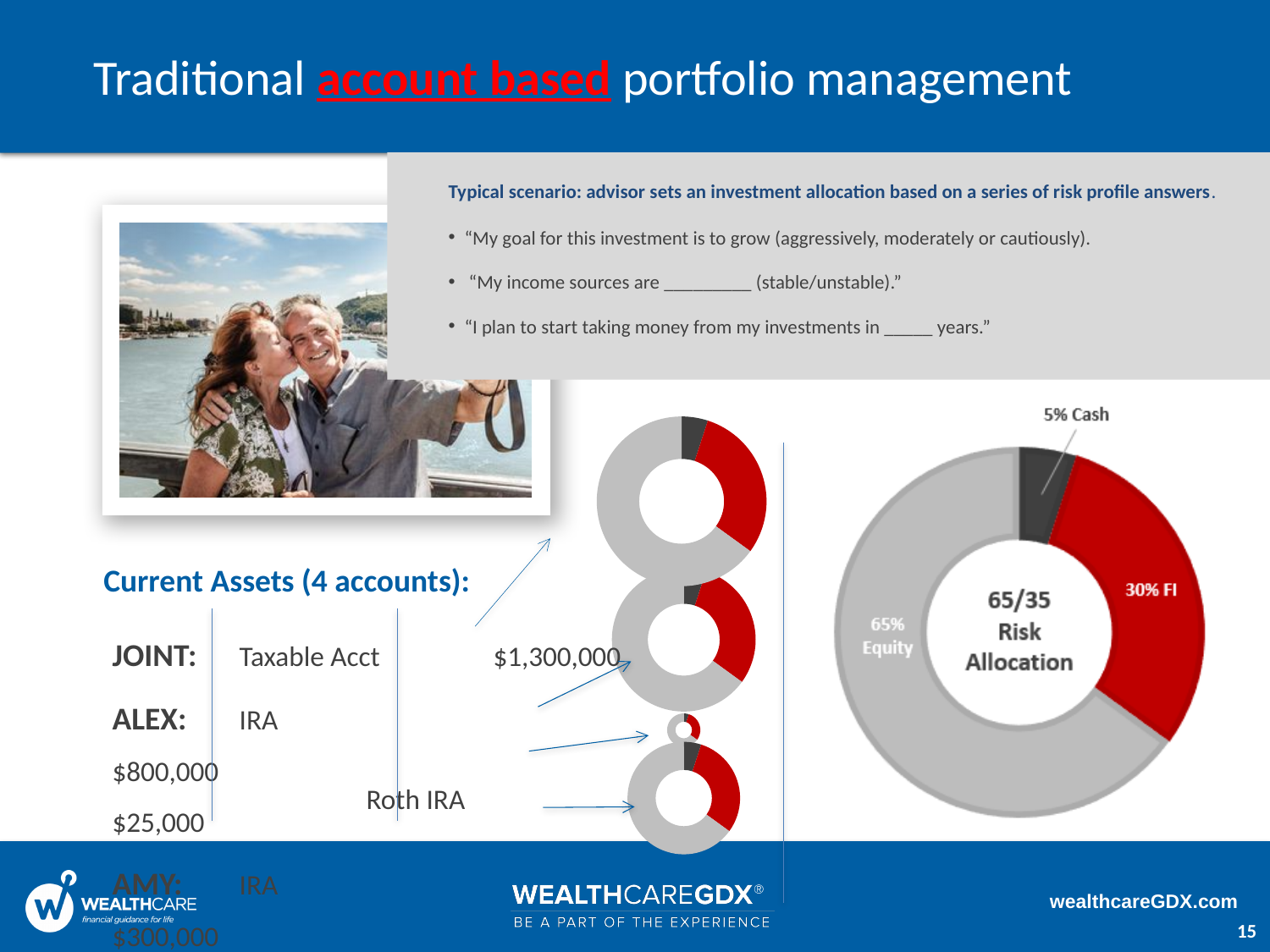
In the large donut chart on the right, what colour is the FI slice? Red What kind of chart is the large chart on the right of the slide? Pie chart (donut) What text is printed in the centre of the large donut chart on the right? 65/35 Risk Allocation In the large donut chart on the right, what percentage is allocated to Equity? 65% In the large donut chart on the right, which slice is the smallest? Cash In the large donut chart on the right, which is larger, the FI slice or the Cash slice? FI In the large donut chart on the right, what percentage is allocated to FI? 30% How many slices does the large donut chart on the right have? 3 In the large donut chart on the right, how many percentage points larger is the Equity slice than the FI slice? 35 In the large donut chart on the right, which slice is the largest? Equity In the large donut chart on the right, what do the three slice percentages add up to? 100% In the large donut chart on the right, what percentage is allocated to Cash? 5%